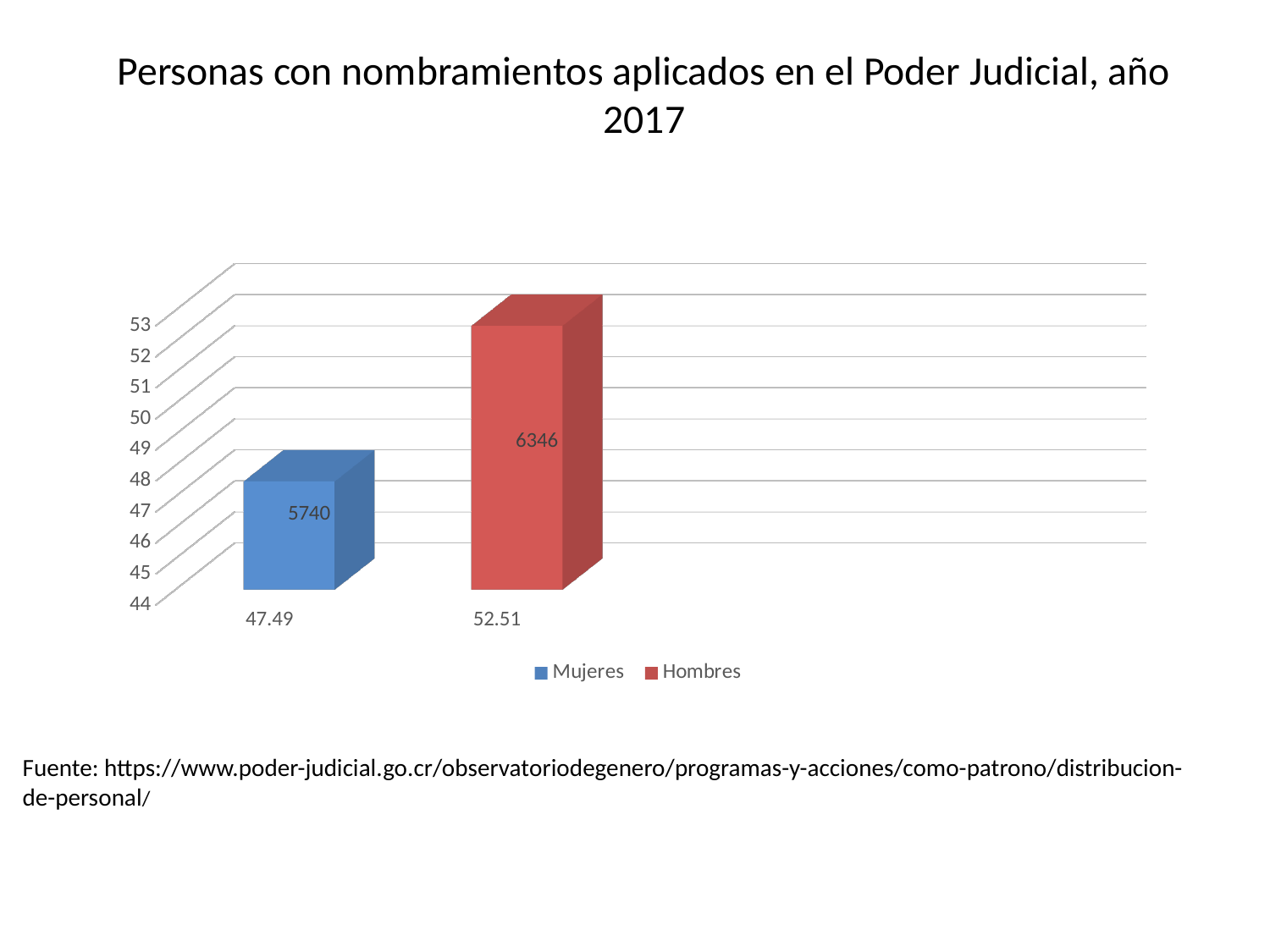
Which series has the shorter bar? Mujeres What kind of chart is shown on the slide? Bar chart Is the Mujeres bar greater or less than 50 on the vertical axis? less What value is printed on the Mujeres bar? 5740 Is the value printed on the Hombres bar larger than the value printed on the Mujeres bar? Yes What colour is the Hombres bar? Red Is the Hombres bar greater or less than 50 on the vertical axis? greater Which series has the taller bar, Mujeres or Hombres? Hombres How many series does the legend list? 2 How many bars are plotted in the chart? 2 What is the difference between the values printed on the Hombres bar and the Mujeres bar? 606 What value is printed on the Hombres bar? 6346